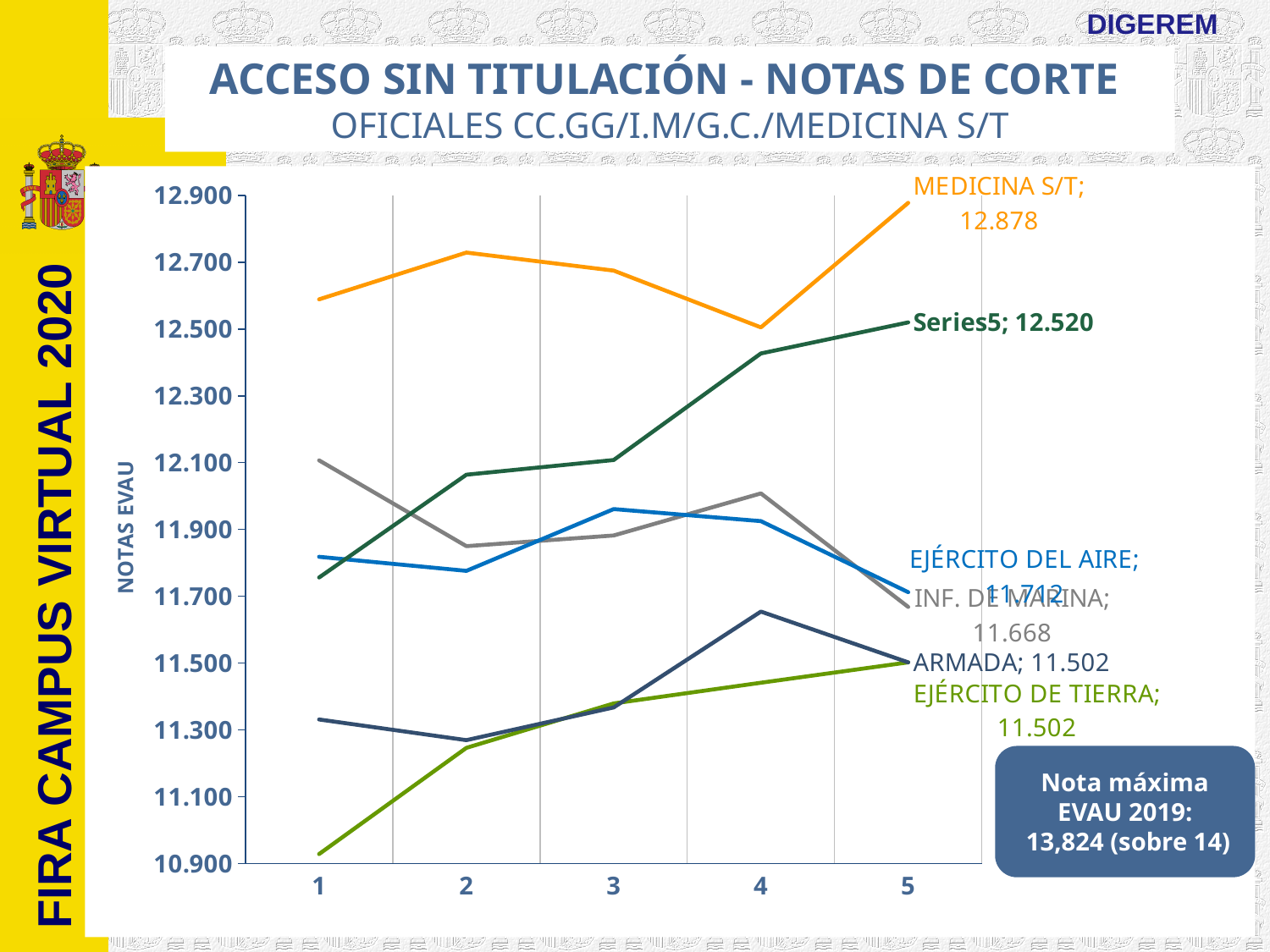
Does the EJÉRCITO DE TIERRA line rise or fall from point 1 to point 5? rise What is the value labelled for MEDICINA S/T at point 5? 12.878 At point 5, which is larger: INF. DE MARINA or ARMADA? INF. DE MARINA What type of chart is shown on the slide? line chart Which series has the highest value at point 5? MEDICINA S/T What is the title of the vertical axis? NOTAS EVAU Is the value for EJÉRCITO DE TIERRA at point 1 greater or less than 11.100? less What is the difference between the MEDICINA S/T and Series5 values at point 5? 0.358 What is the value labelled for INF. DE MARINA at point 5? 11.668 What is the value labelled for EJÉRCITO DE TIERRA at point 5? 11.502 What is the value labelled for Series5 at point 5? 12.520 What is the value labelled for ARMADA at point 5? 11.502